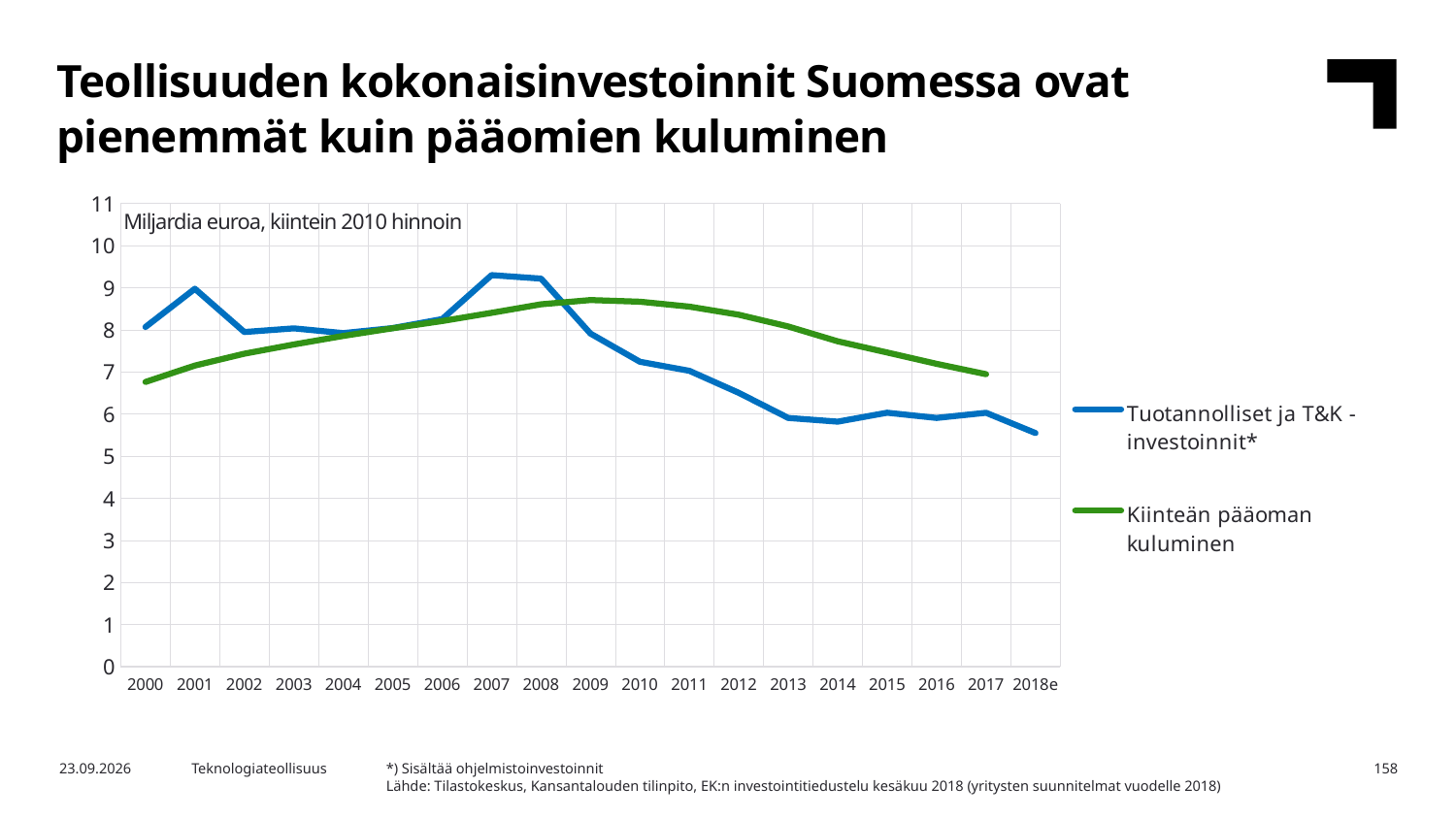
In which year is the Kiinteän pääoman kuluminen series at its lowest? 2000 Is the value for Kiinteän pääoman kuluminen in 2000 greater or less than 7? less What unit is stated in the text at the top of the chart area? Miljardia euroa, kiintein 2010 hinnoin Is the value for Tuotannolliset ja T&K -investoinnit* in 2001 greater or less than 8? greater Does the Kiinteän pääoman kuluminen series rise or fall from 2009 to 2017? fall In 2017, which series has the higher value: Tuotannolliset ja T&K -investoinnit* or Kiinteän pääoman kuluminen? Kiinteän pääoman kuluminen How many years are shown on the x axis? 19 Is the value for Kiinteän pääoman kuluminen in 2009 greater or less than 8? greater In 2001, which series has the higher value: Tuotannolliset ja T&K -investoinnit* or Kiinteän pääoman kuluminen? Tuotannolliset ja T&K -investoinnit* How many series does the legend list? 2 What type of chart is shown on the slide? line chart